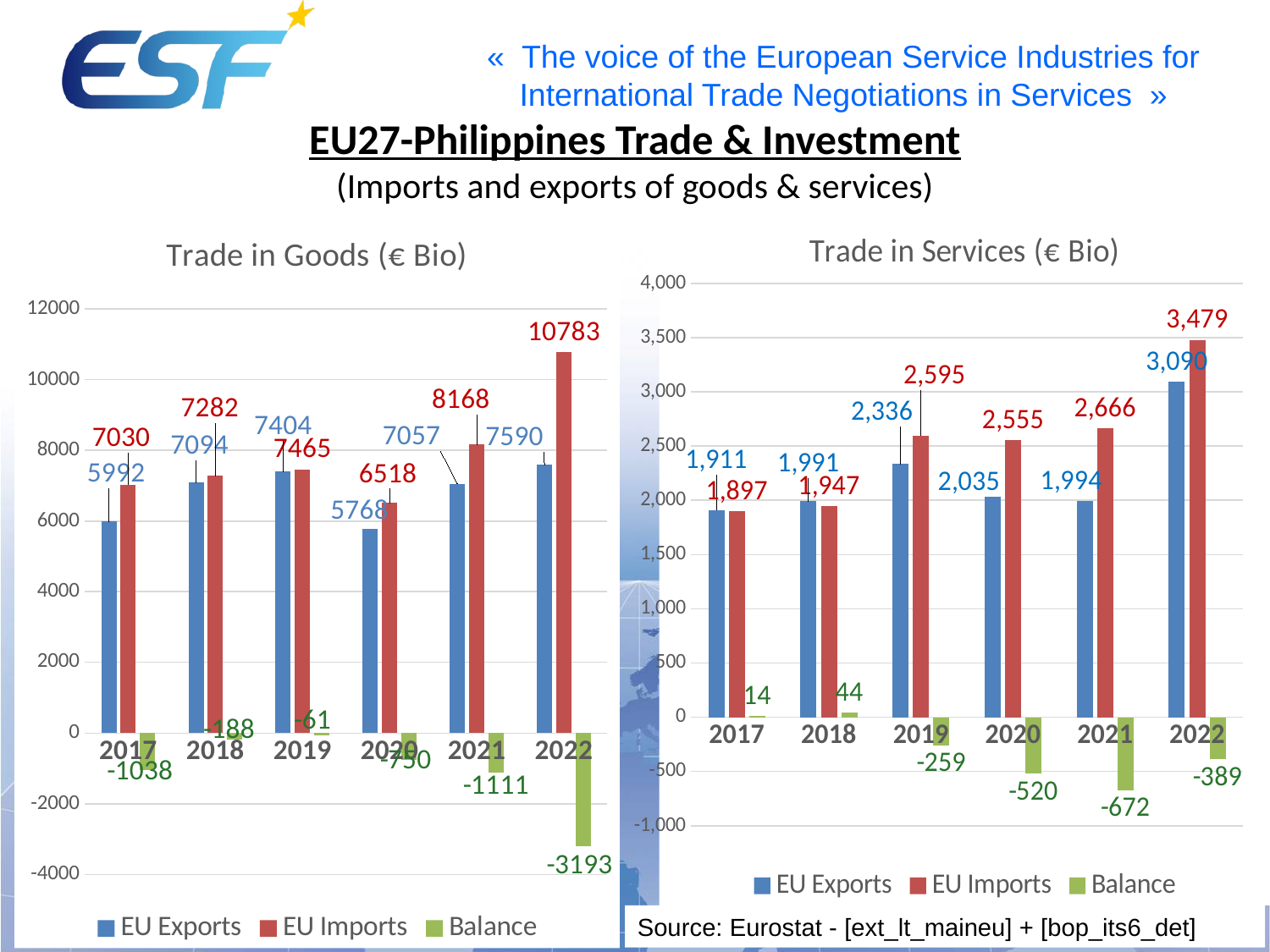
In the Trade in Services chart, which is larger in 2017, EU Exports or EU Imports? EU Exports In the Trade in Goods chart, what is the value of EU Exports in 2020? 5768 In the Trade in Goods chart, what is the difference between EU Imports and EU Exports in 2021? 1111 What type of chart is the Trade in Goods chart? Bar chart In the Trade in Services chart, what is the value of EU Exports in 2022? 3,090 In the Trade in Goods chart, what is the value of EU Imports in 2022? 10783 In the Trade in Services chart, what is the difference between EU Imports in 2022 and EU Imports in 2021? 813 In the Trade in Services chart, what is the Balance in 2021? -672 How many series does the legend of the Trade in Services chart list? 3 In the Trade in Goods chart, which is larger in 2019, EU Exports or EU Imports? EU Imports In the Trade in Services chart, which year has the highest EU Imports? 2022 In the Trade in Goods chart, which year has the lowest Balance? 2022